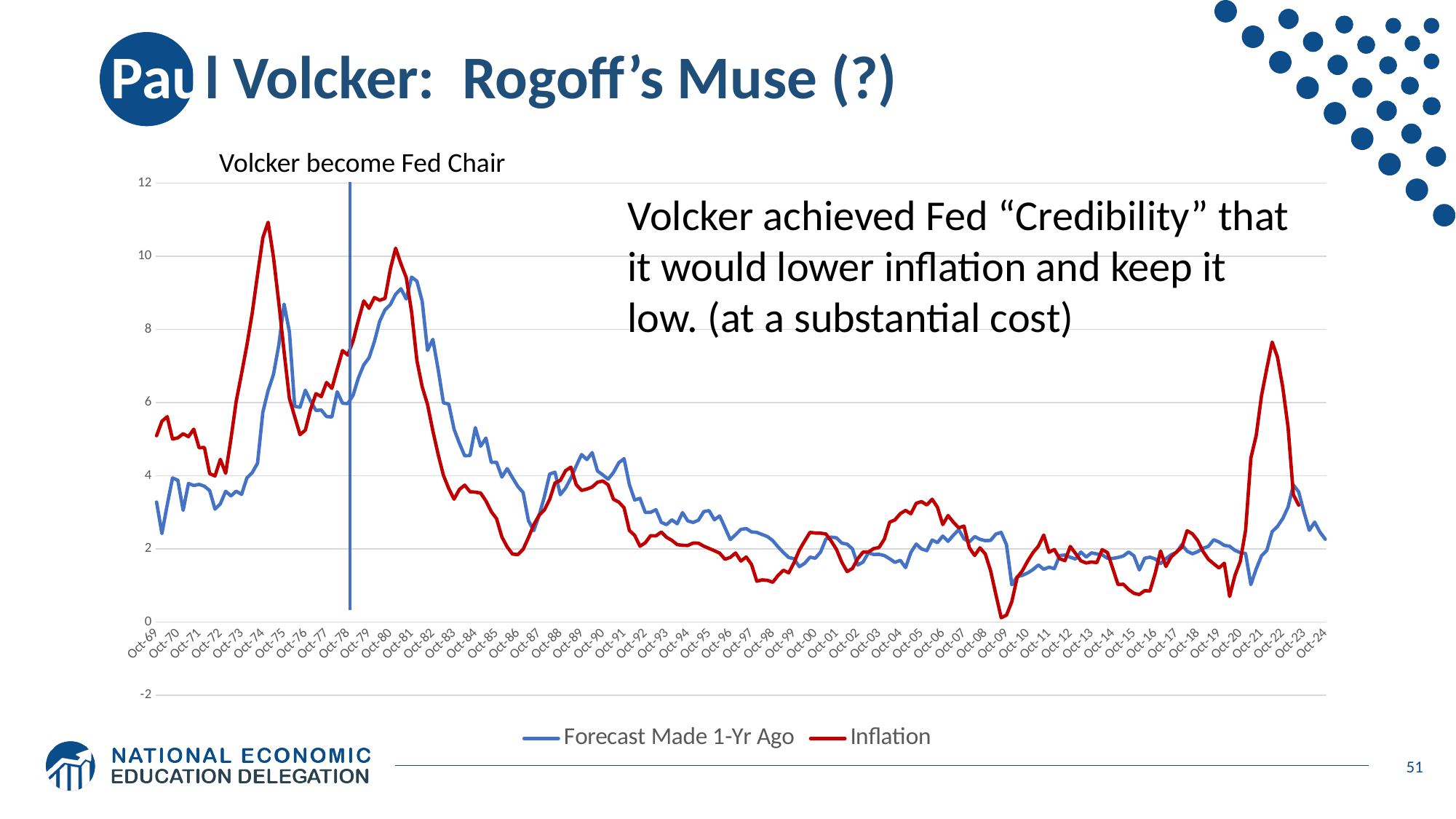
How many series does the legend list? 2 Is the peak value of Inflation around Oct-74 greater or less than 10? greater What event does the vertical line annotation on the chart mark? Volcker become Fed Chair What are the two series named in the legend? Forecast Made 1-Yr Ago and Inflation What kind of chart is shown on the slide? Line chart Which series is drawn in red? Inflation Is the peak value of Inflation around Oct-21 to Oct-22 greater or less than 6? greater Is the value of Inflation around Oct-98 greater or less than 2? less Does Inflation rise or fall between Oct-81 and Oct-86? Fall Which series reaches the highest value anywhere on the chart? Inflation Around Oct-74, which series has the higher value, Forecast Made 1-Yr Ago or Inflation? Inflation